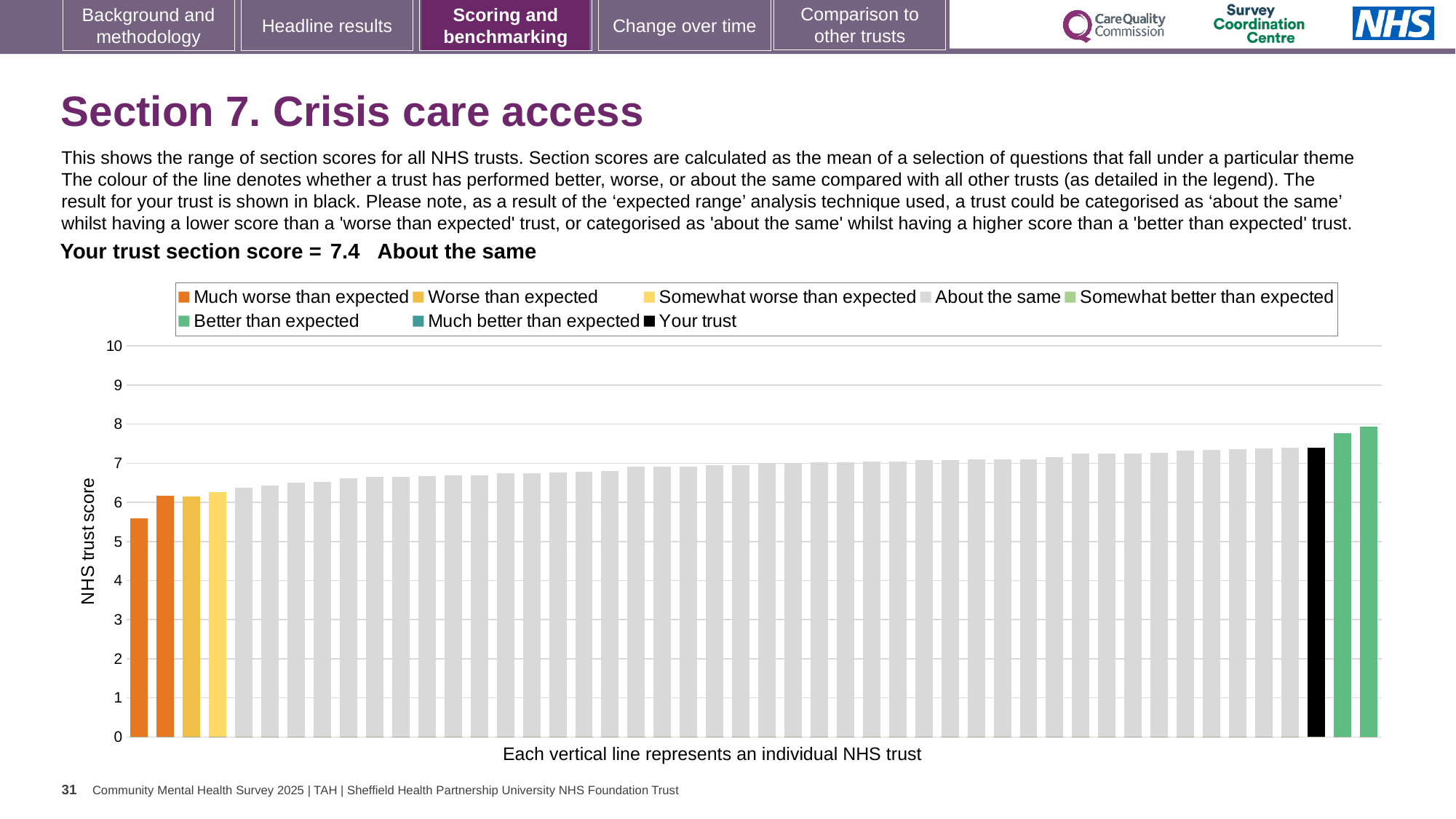
What is the section score for your trust shown on the slide? 7.4 Is the value of the black 'Your trust' bar greater or less than 7? greater Is the value of the lowest (leftmost) bar greater or less than 6? less What kind of chart is used to show the range of section scores? Bar chart Which performance category is your trust placed in for crisis care access? About the same Is the value of the highest (rightmost) bar greater or less than 8? less Which colour of bar is the lowest on the chart? Orange (Much worse than expected) Which colour of bar is the highest on the chart? Green (Better than expected) How many entries does the chart legend list? 8 Which is larger: the black 'Your trust' bar or the leftmost orange bar? The black 'Your trust' bar Do the trust scores rise or fall from left to right along the x axis? Rise What is the label on the vertical axis of the chart? NHS trust score